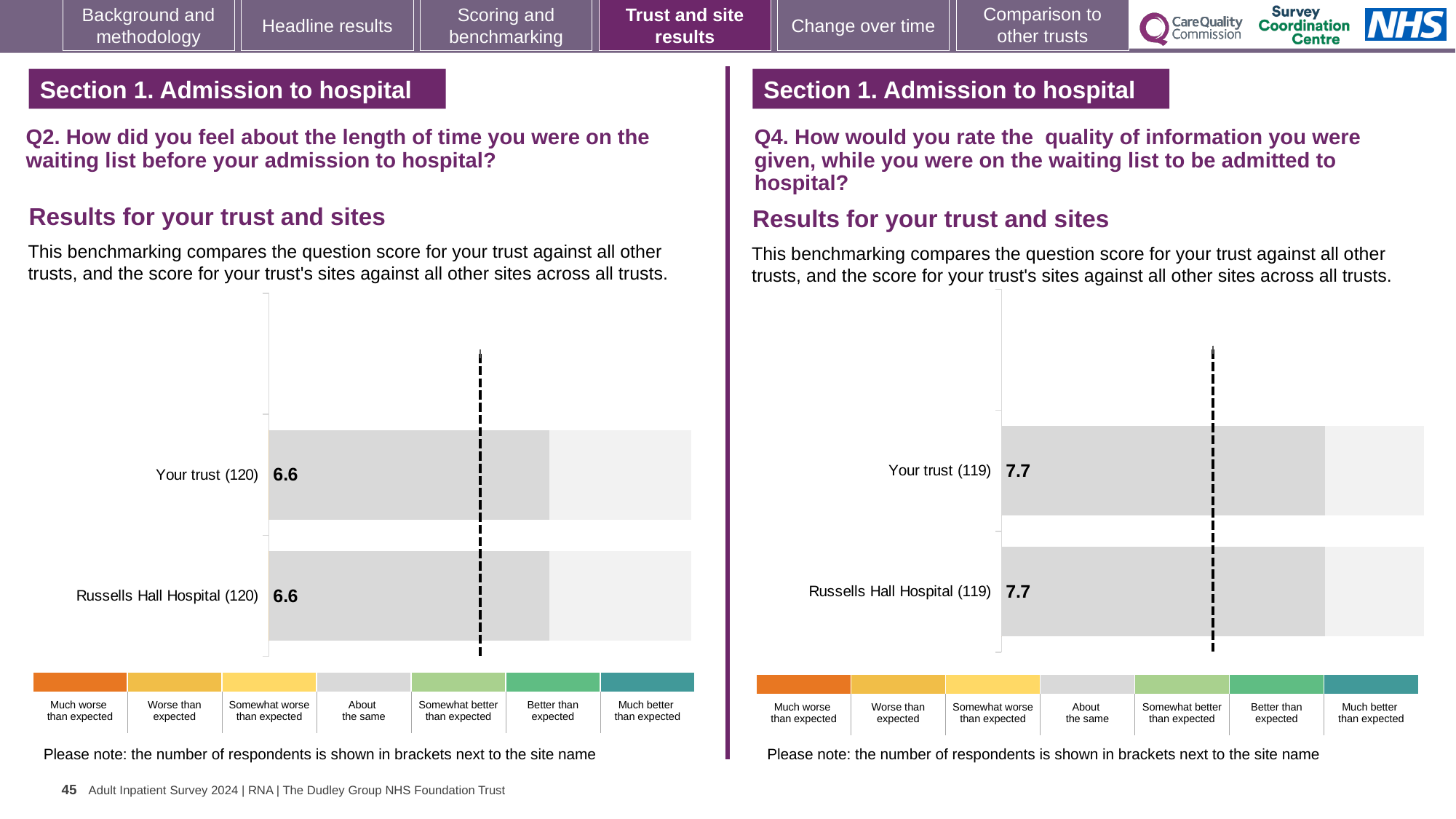
How many bars are plotted in the left chart (Q2)? 2 In the left chart (Q2), what is the score for Your trust? 6.6 In the right chart (Q4), how many respondents are shown in brackets for Russells Hall Hospital? 119 In the right chart (Q4), what is the score for Your trust? 7.7 How many bars are plotted in the right chart (Q4)? 2 In the right chart (Q4), what is the difference between the score for Your trust and the score for Russells Hall Hospital? 0.0 Is the score for Your trust in the right chart (Q4) greater or less than the score for Your trust in the left chart (Q2)? greater In the left chart (Q2), what is the score for Russells Hall Hospital? 6.6 In the left chart (Q2), what is the difference between the score for Your trust and the score for Russells Hall Hospital? 0.0 In the left chart (Q2), how many respondents are shown in brackets for Your trust? 120 What kind of chart is used in the left chart (Q2)? Bar chart In the right chart (Q4), what is the score for Russells Hall Hospital? 7.7